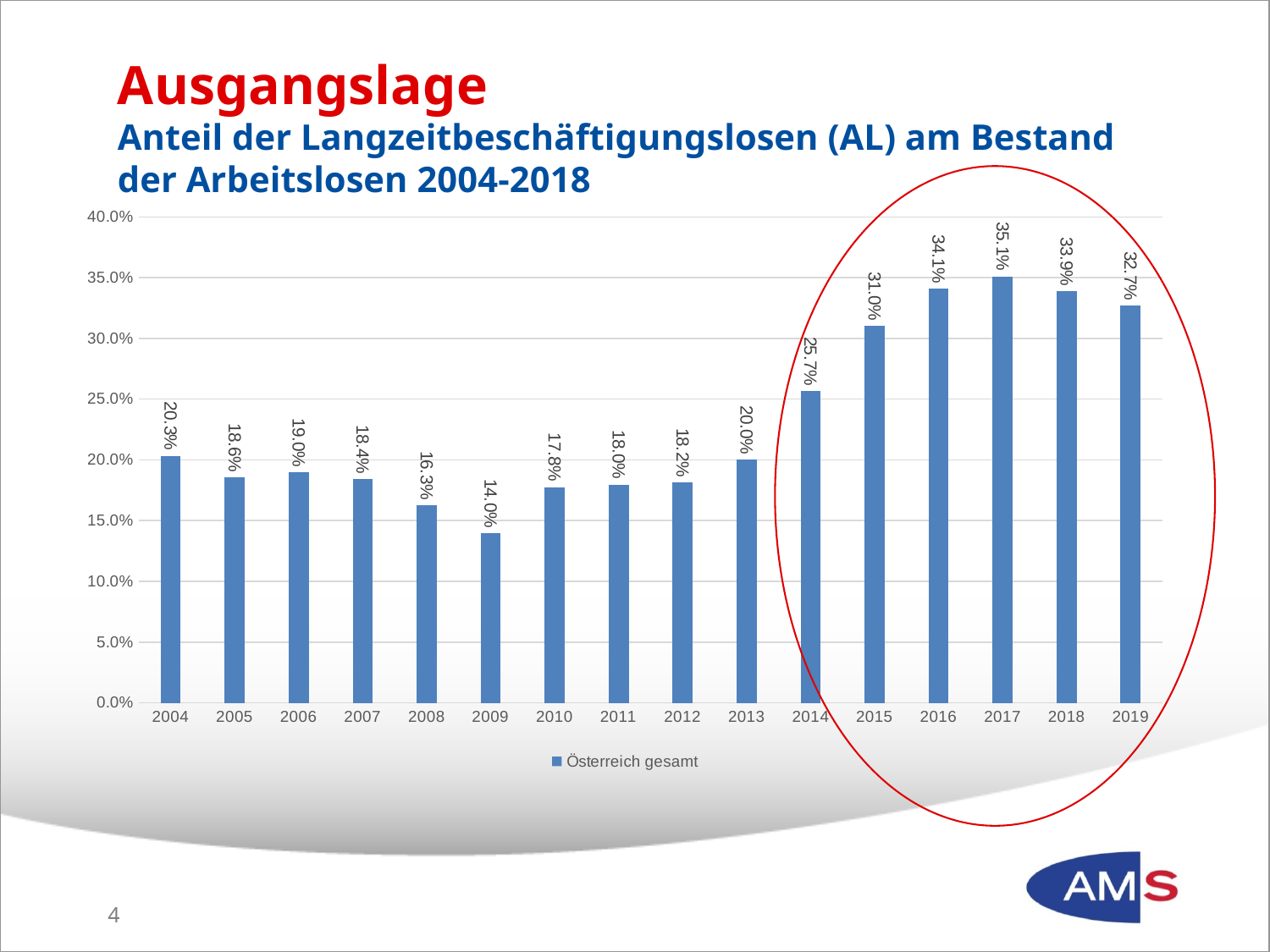
What is the value for 2017? 35.1% What kind of chart is shown on the slide? Bar chart What is the difference between the values for 2017 and 2009? 21.1% Which is larger, the value for 2004 or the value for 2013? 2004 What is the value for 2009? 14.0% What is the single legend entry of the chart? Österreich gesamt Which year has the lowest value? 2009 Is the value for 2016 greater or less than 30.0%? greater What is the difference between the values for 2015 and 2014? 5.3% How many years are shown on the x axis? 16 What is the value for 2014? 25.7% Which year has the highest value? 2017